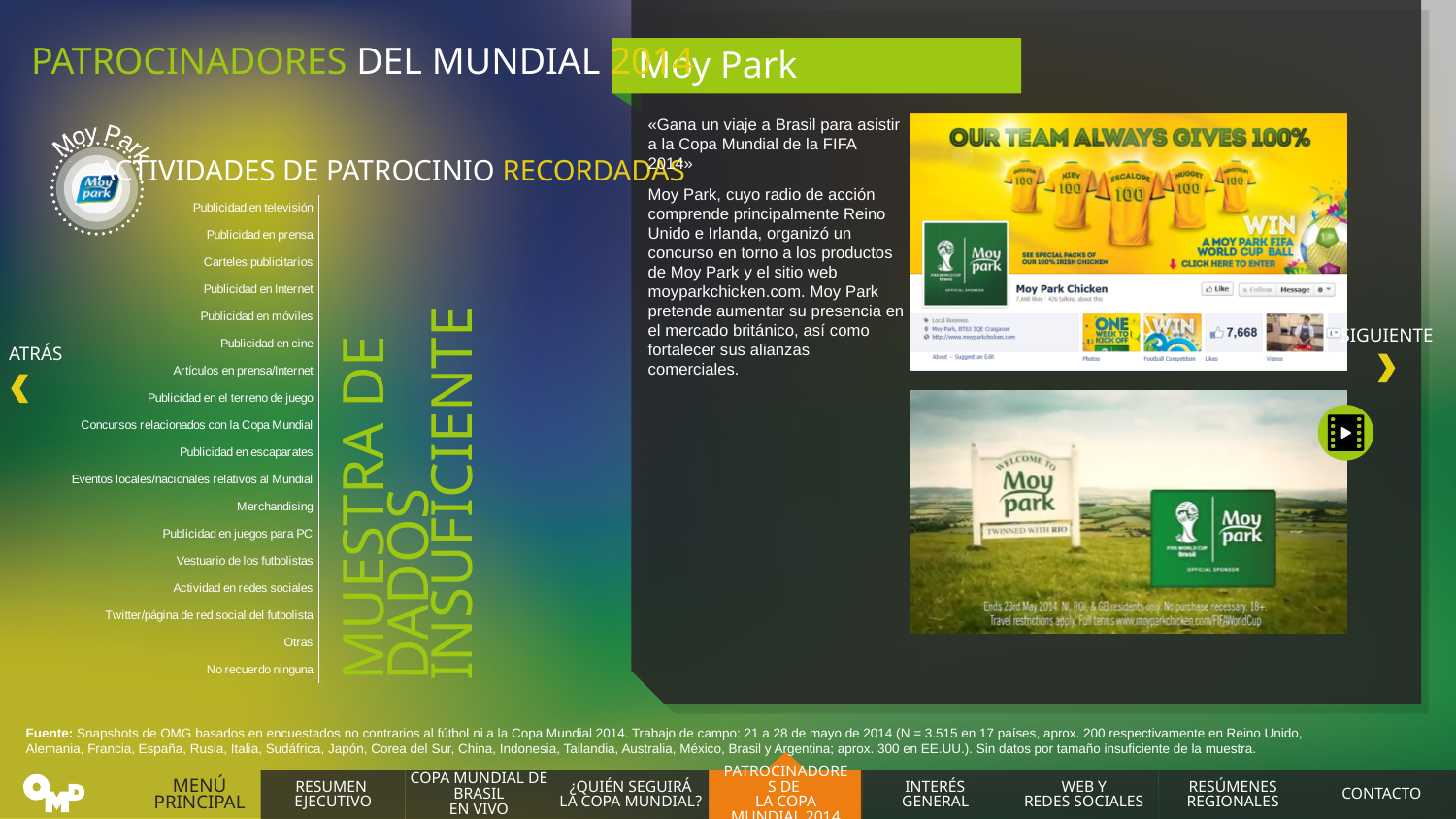
What is the first category listed at the top of the chart's axis? Publicidad en televisión Why does the chart show no plotted values? Muestra de datos insuficiente What is the last category listed at the bottom of the chart's axis? No recuerdo ninguna What is the title of the chart on the left side of the slide? ACTIVIDADES DE PATROCINIO RECORDADAS How many categories are listed on the chart's axis? 18